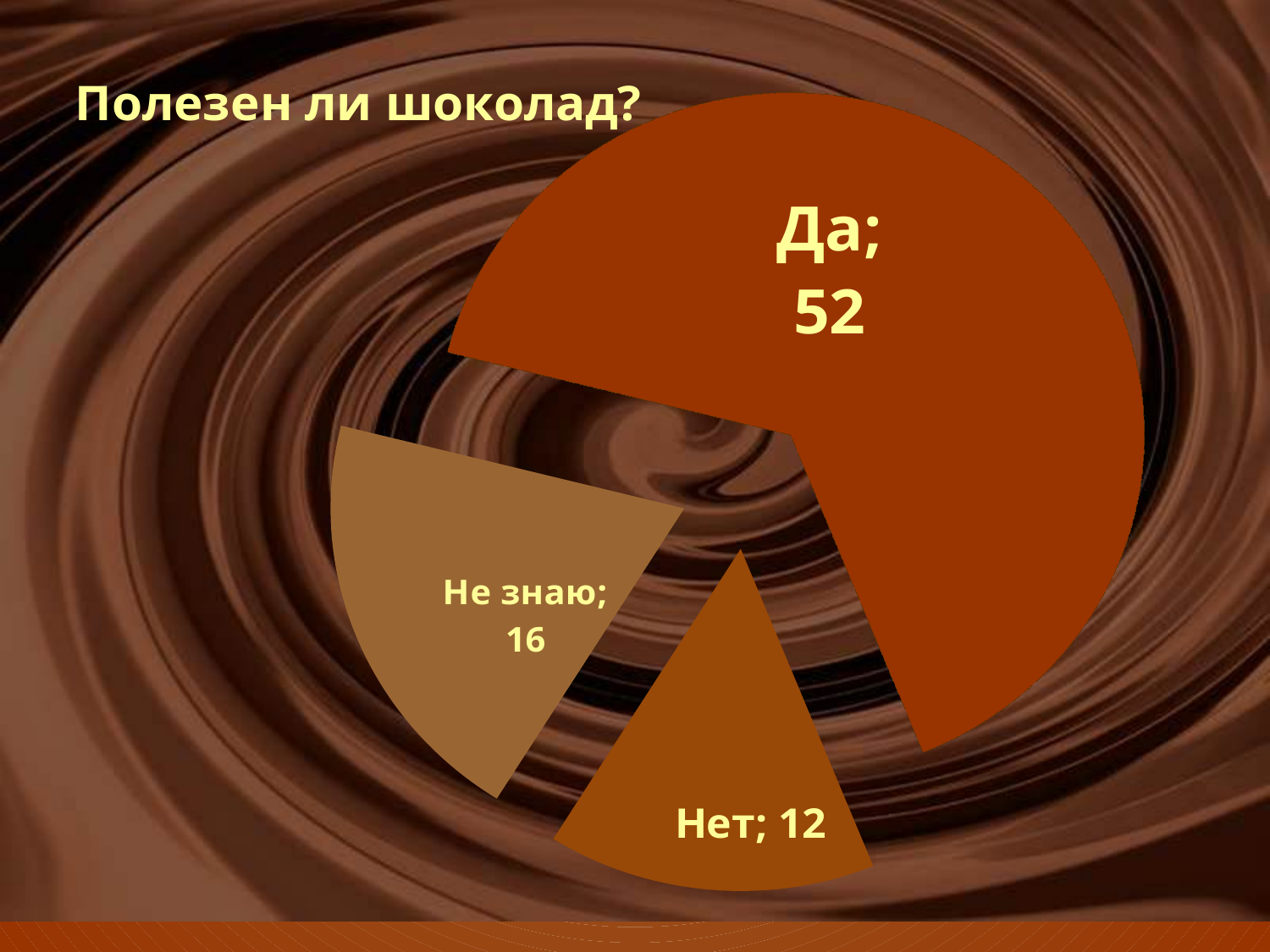
Which slice has the highest value? Да What share of the pie does the "Да" slice represent? 65% Which is larger, the value for "Не знаю" or the value for "Нет"? Не знаю What is the difference between the values for "Да" and "Нет"? 40 What kind of chart is shown on the slide? Pie chart What is the value for the "Да" slice? 52 What is the title of the chart? Полезен ли шоколад? What is the difference between the values for "Не знаю" and "Нет"? 4 Which slice has the lowest value? Нет What is the value for the "Нет" slice? 12 What is the value for the "Не знаю" slice? 16 How many slices does the pie chart have? 3